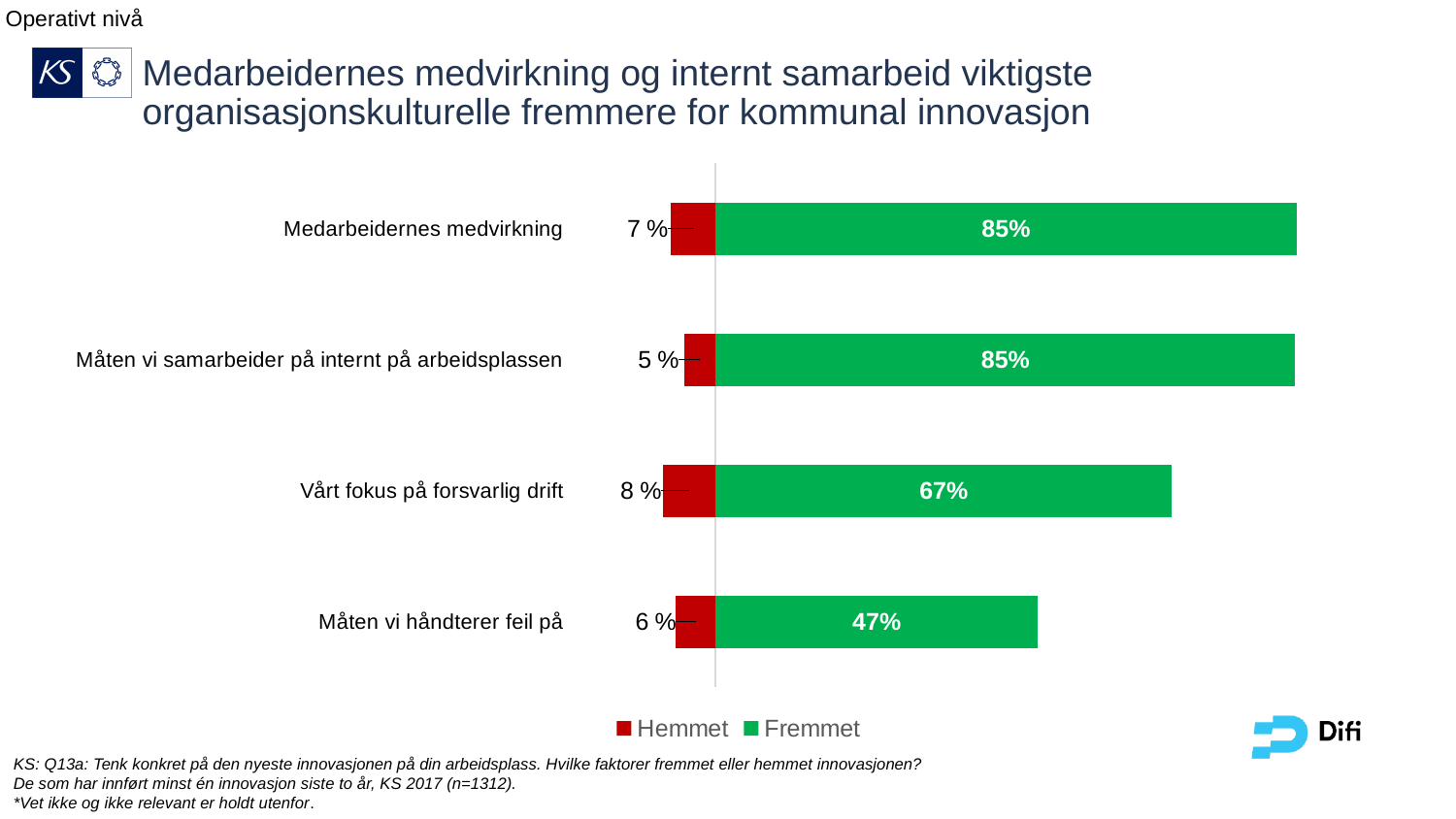
What is the Hemmet value for Måten vi samarbeider på internt på arbeidsplassen? 5 % Which has a larger Fremmet value: Vårt fokus på forsvarlig drift or Måten vi håndterer feil på? Vårt fokus på forsvarlig drift What is the Fremmet value for Medarbeidernes medvirkning? 85% What is the Fremmet value for Måten vi håndterer feil på? 47% What is the Hemmet value for Vårt fokus på forsvarlig drift? 8 % What kind of chart is shown on the slide? Bar chart What is the difference between the Fremmet values for Medarbeidernes medvirkning and Vårt fokus på forsvarlig drift? 18 percentage points Which category has the lowest Fremmet value? Måten vi håndterer feil på Which category has the lowest Hemmet value? Måten vi samarbeider på internt på arbeidsplassen How many series does the legend list? 2 Which category has the highest Hemmet value? Vårt fokus på forsvarlig drift How many categories are shown in the chart? 4